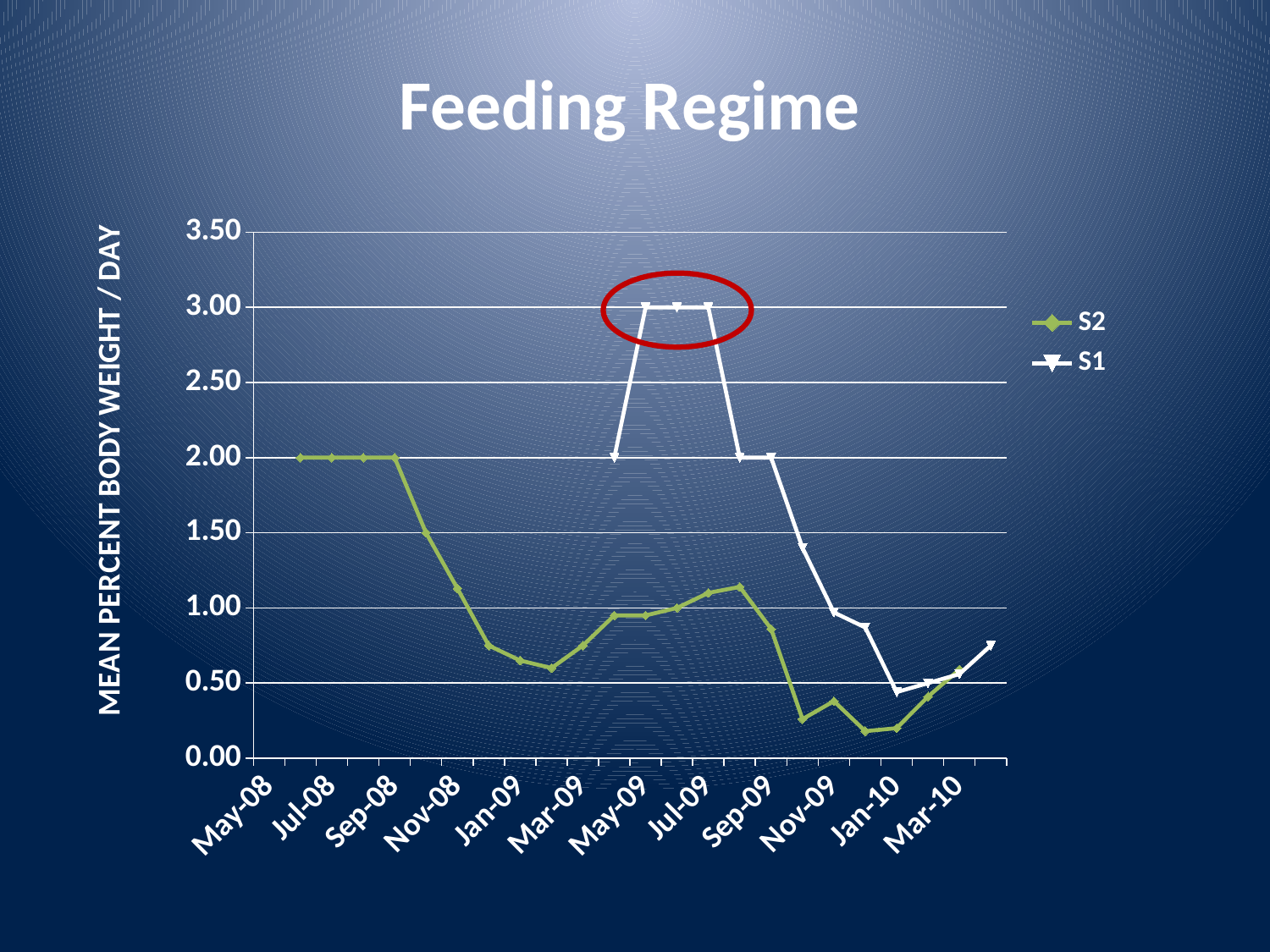
What is the highest value reached by series S1? 3.00 What is the difference between the S1 value at Jul-09 and the S1 value at Sep-09? 1.00 What is the value of S1 at Sep-09? 2.00 What is the label on the vertical axis? MEAN PERCENT BODY WEIGHT / DAY How many series does the legend list? 2 Is the value for S2 at Jan-10 greater or less than 0.50? less Does the S2 line rise or fall between Sep-08 and Mar-09? fall What kind of chart is shown on the slide? line chart What is the value of S2 at Sep-08? 2.00 What is the value of S1 at Jul-09? 3.00 What is the title of the chart? Feeding Regime At Jul-09, which series has the larger value, S1 or S2? S1